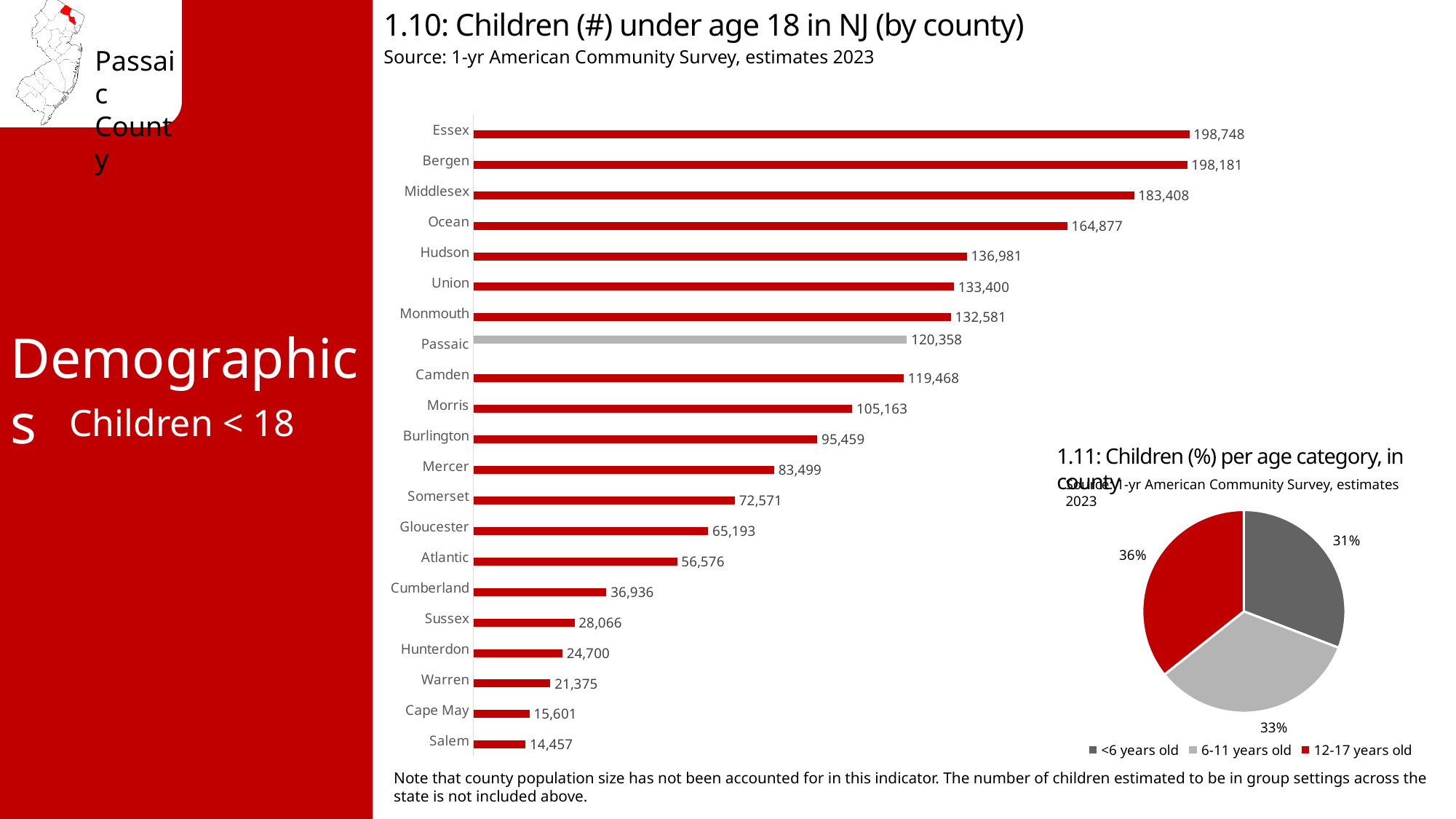
In chart 1.10, which bar is coloured grey instead of red? Passaic In chart 1.10, how many children under age 18 are in Passaic County? 120,358 In chart 1.10, which county has the lowest number of children under 18? Salem In chart 1.10, what is the value for Ocean County? 164,877 What kind of chart is chart 1.11? Pie chart What kind of chart is chart 1.10? Bar chart In chart 1.10, which county has more children under 18, Hudson or Union? Hudson In chart 1.11, which age category has the largest share? 12-17 years old In chart 1.11, what percentage of children are 6-11 years old? 33% In chart 1.10, what is the difference between the values for Passaic and Camden? 890 In chart 1.11, how many age categories does the legend list? 3 In chart 1.10, how many counties are shown? 21